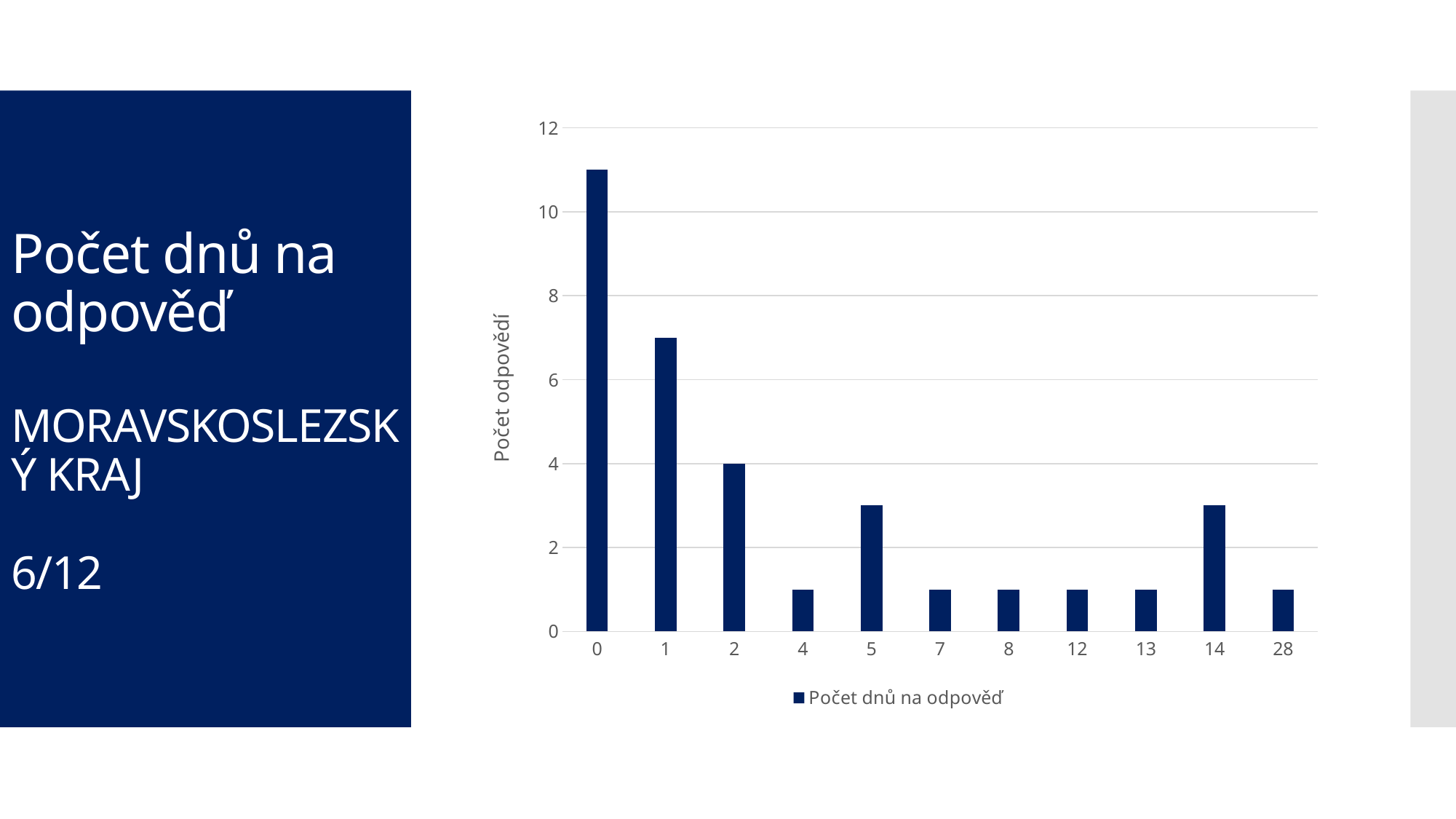
Is the value for category 14 greater or less than 4? less Which category has the highest bar in the chart? 0 Which has the larger value, category 1 or category 2? 1 Is the value for category 0 greater or less than 10? greater Is the value for category 28 greater or less than 2? less How many categories are shown on the x axis of the chart? 11 How many series does the chart legend list? 1 What kind of chart is shown on the slide? bar chart Which has the larger value, category 5 or category 4? 5 What is the series name shown in the chart legend? Počet dnů na odpověď What is the value for category 2 in the chart? 4